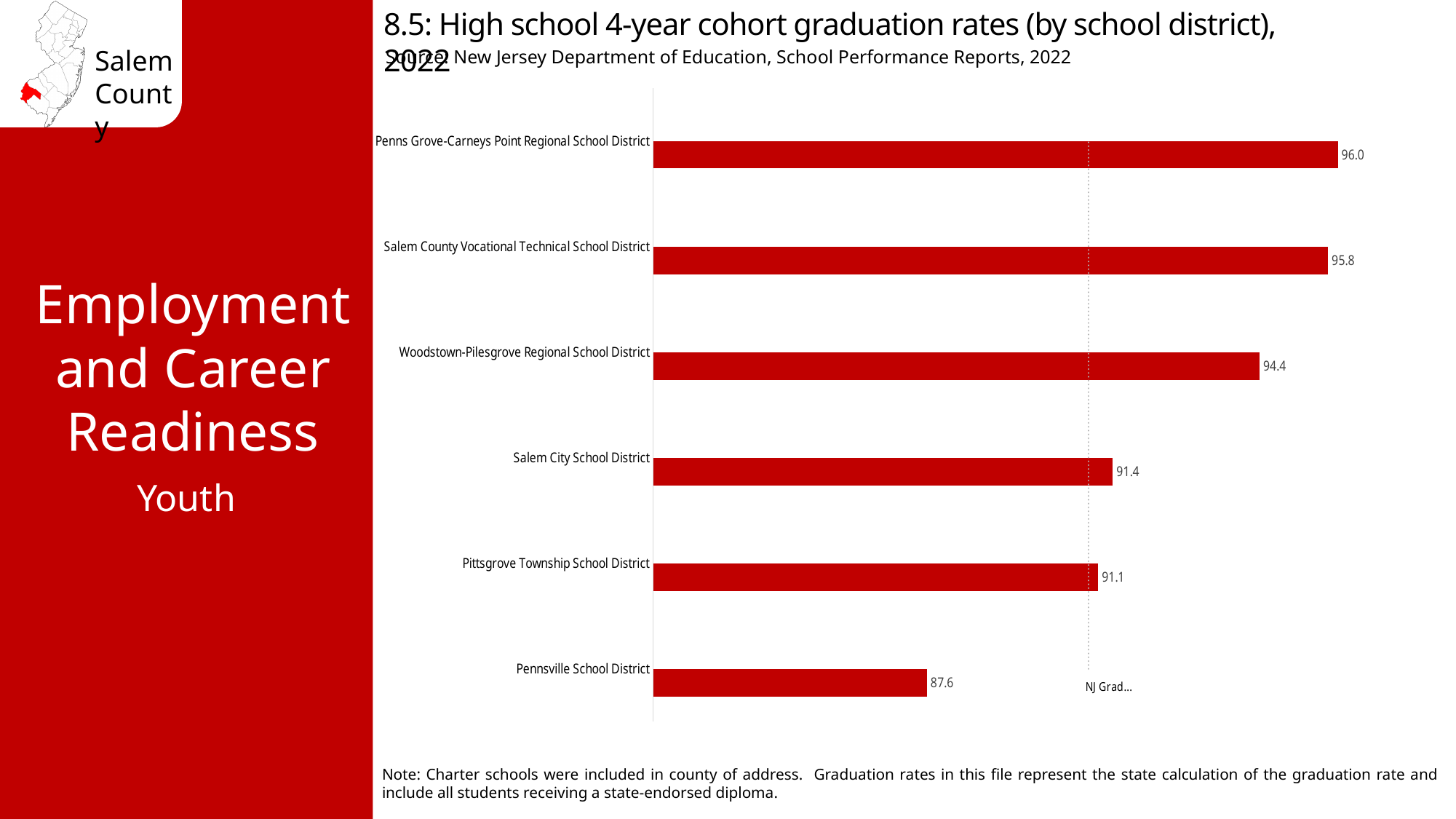
What is the title of the chart? 8.5: High school 4-year cohort graduation rates (by school district), 2022 What is the graduation rate for Penns Grove-Carneys Point Regional School District? 96.0 How many school districts are shown in the chart? 6 What is the graduation rate for Pennsville School District? 87.6 What is the difference between the graduation rates of Penns Grove-Carneys Point Regional School District and Woodstown-Pilesgrove Regional School District? 1.6 What type of chart is shown on the slide? Bar chart What is the graduation rate for Woodstown-Pilesgrove Regional School District? 94.4 What is the graduation rate for Salem County Vocational Technical School District? 95.8 What is the difference between the graduation rates of Salem City School District and Pennsville School District? 3.8 Which school district has the highest graduation rate? Penns Grove-Carneys Point Regional School District Which has a higher graduation rate, Woodstown-Pilesgrove Regional School District or Pittsgrove Township School District? Woodstown-Pilesgrove Regional School District Which school district has the lowest graduation rate? Pennsville School District